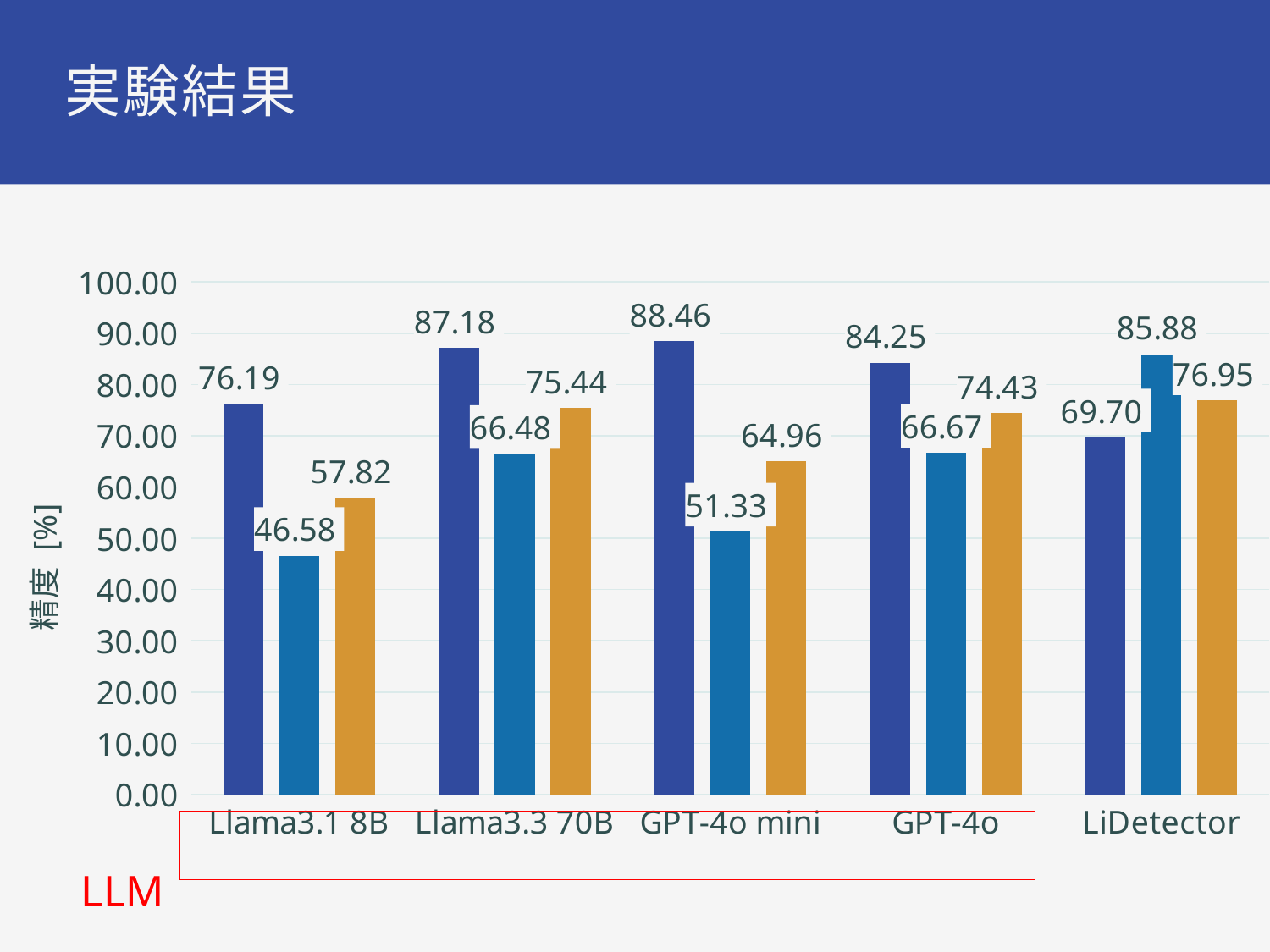
Which category has the highest light blue bar? LiDetector What kind of chart is shown on the slide? bar chart What is the label of the y axis? 精度 [%] What is the value of the dark blue bar for GPT-4o mini? 88.46 Which is larger for LiDetector: the dark blue bar or the light blue bar? the light blue bar What is the difference between the dark blue bar and the light blue bar for GPT-4o mini? 37.13 How many categories are shown on the x axis? 5 Which category has the highest dark blue bar? GPT-4o mini What is the value of the orange bar for LiDetector? 76.95 What is the value of the light blue bar for Llama3.1 8B? 46.58 Is the orange bar for Llama3.1 8B greater or less than 60.00? less Which category has the lowest light blue bar? Llama3.1 8B